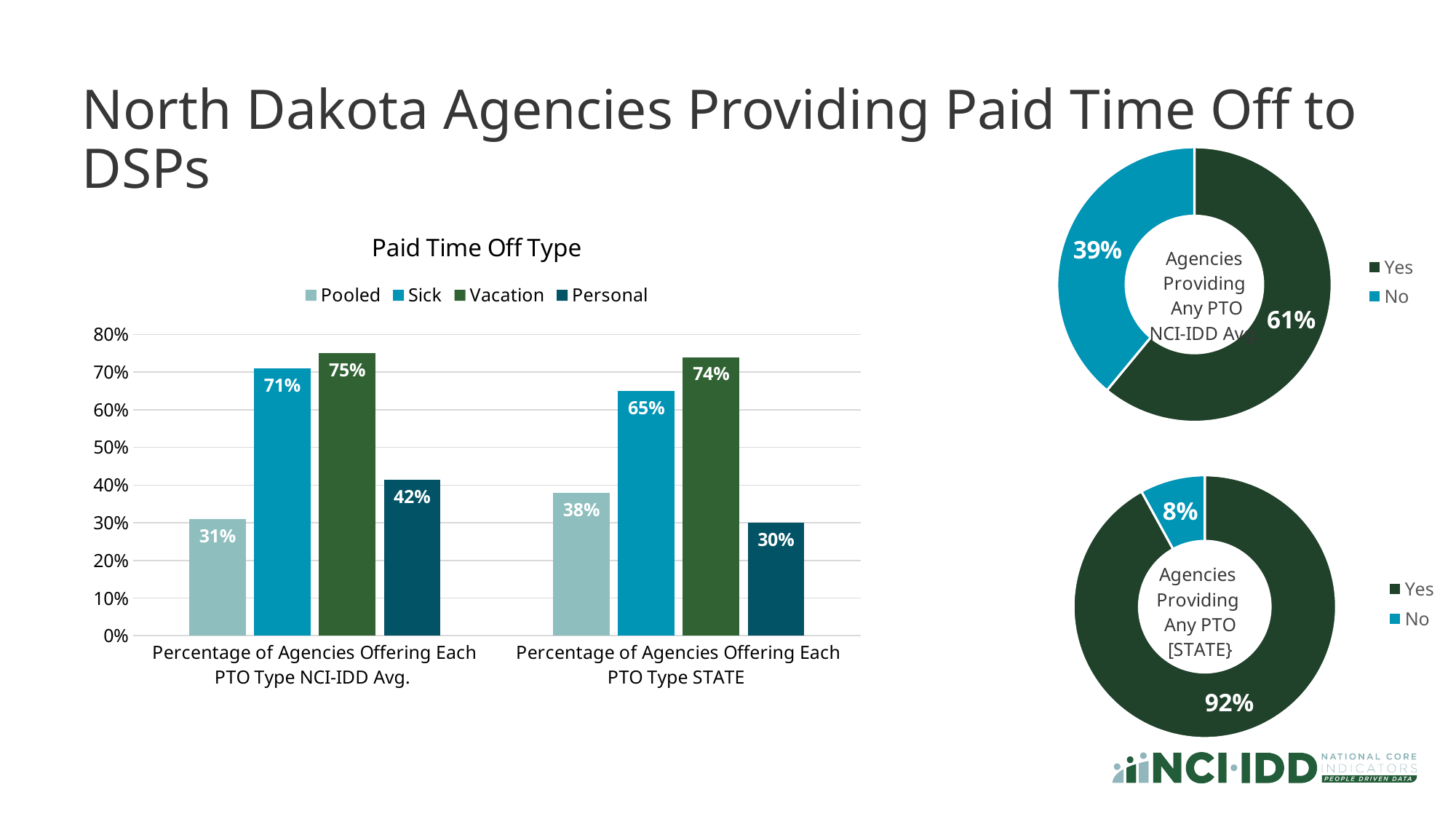
In the 'Paid Time Off Type' bar chart, which colour represents the Vacation series? Green In the 'Paid Time Off Type' bar chart, what is the difference between the Personal values for the NCI-IDD Avg. group and the STATE group? 12% In the 'Paid Time Off Type' bar chart, which PTO type has the lowest value in the NCI-IDD Avg. group? Pooled In the 'Paid Time Off Type' bar chart, which PTO type has the highest value in the STATE group? Vacation In the 'Agencies Providing Any PTO [STATE}' donut chart, what share of agencies answered No? 8% In the 'Paid Time Off Type' bar chart, is the Sick value larger for the NCI-IDD Avg. group or the STATE group? NCI-IDD Avg. What is the difference between the Yes share in the 'Agencies Providing Any PTO [STATE}' donut chart and the Yes share in the 'Agencies Providing Any PTO NCI-IDD Avg' donut chart? 31% How many series does the legend of the 'Paid Time Off Type' bar chart list? 4 What kind of chart is the 'Paid Time Off Type' chart? Bar chart In the 'Paid Time Off Type' bar chart, what is the value for Pooled in the STATE group? 38% In the 'Paid Time Off Type' bar chart, what percentage of agencies offer Sick leave in the NCI-IDD Avg. group? 71% In the 'Agencies Providing Any PTO NCI-IDD Avg' donut chart, what share of agencies answered Yes? 61%